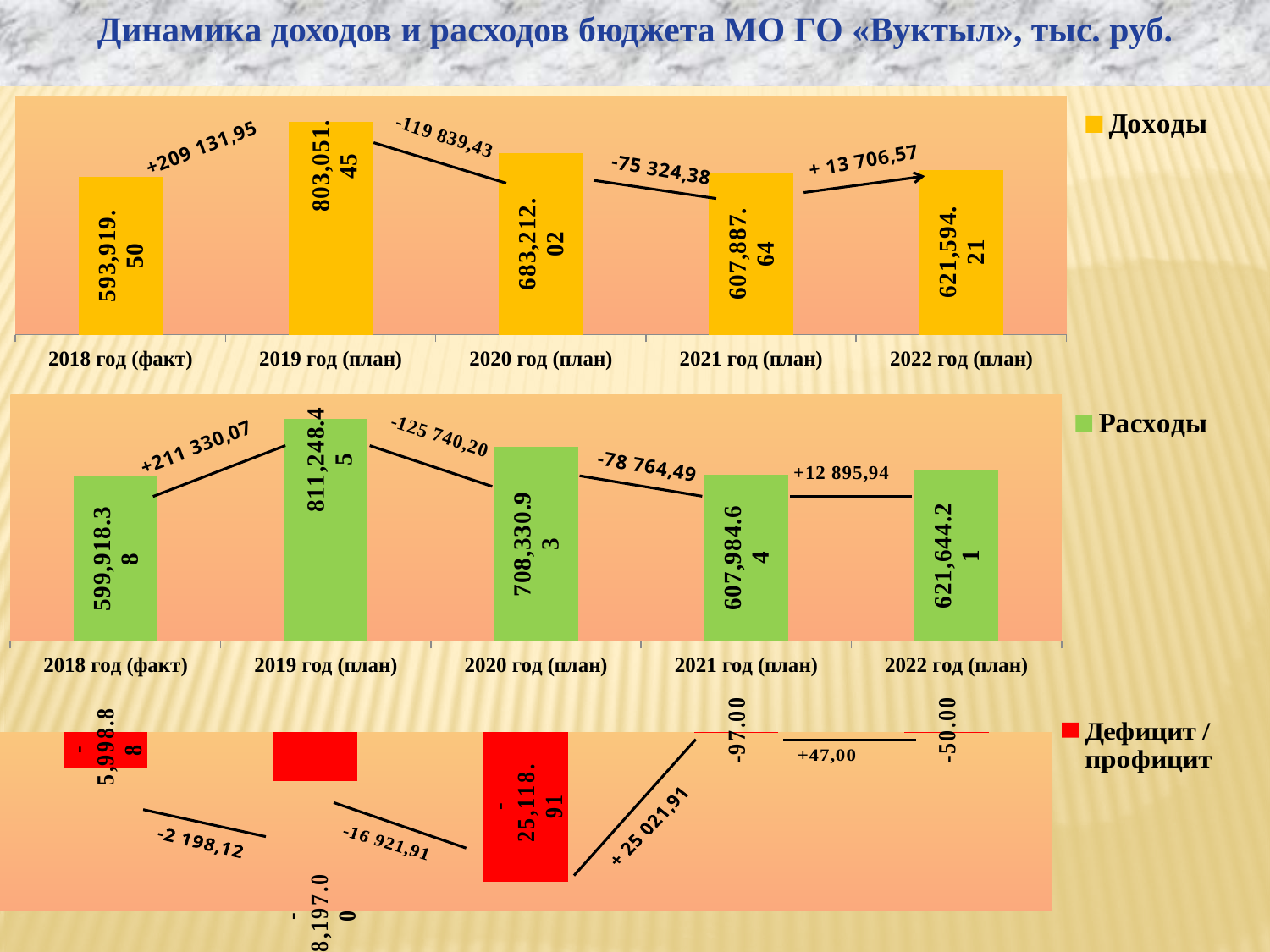
On the Дефицит / профицит chart, what is the value for 2020 год (план)? -25,118.91 On the Доходы chart, which year has the lowest value? 2018 год (факт) On the Расходы chart, what is the value for 2020 год (план)? 708,330.93 What kind of chart is the Расходы chart? Bar chart On the Доходы chart, which year has the highest value? 2019 год (план) On the Доходы chart, what change is annotated between 2018 год (факт) and 2019 год (план)? +209 131,95 On the Расходы chart, which year has the highest value? 2019 год (план) On the Доходы chart, what is the value for 2019 год (план)? 803,051.45 On the Доходы chart, how many years are shown on the x axis? 5 On the Расходы chart, what is the value for 2022 год (план)? 621,644.21 On the Доходы chart, what is the value for 2018 год (факт)? 593,919.50 On the Дефицит / профицит chart, what is the value for 2021 год (план)? -97.00